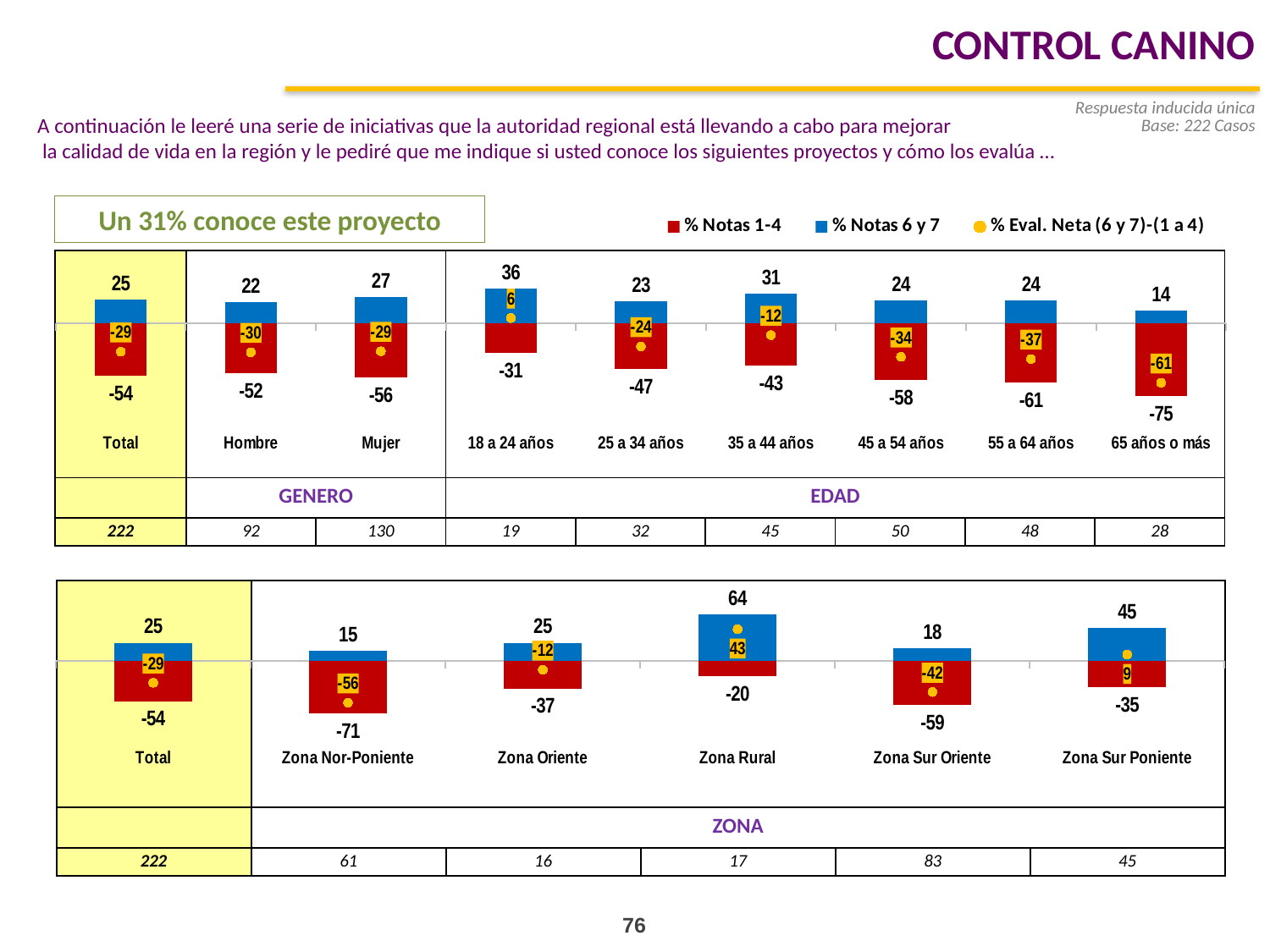
In the top chart, what is the % Notas 6 y 7 value for 18 a 24 años? 36 In the bottom chart, what is the % Eval. Neta value for Zona Sur Poniente? 9 In the top chart, what is the difference between the % Notas 6 y 7 values for Mujer and Hombre? 5 In the bottom chart, which zone has the lowest % Notas 1-4 value? Zona Nor-Poniente In the bottom chart, which is larger, the % Notas 6 y 7 value for Zona Sur Poniente or for Zona Sur Oriente? Zona Sur Poniente In the top chart, which age group has the highest % Notas 6 y 7 value? 18 a 24 años In the bottom chart, what is the % Notas 6 y 7 value for Zona Rural? 64 In the top chart, what is the % Eval. Neta value for Hombre? -30 How many series does the legend list? 3 What kind of chart is the bottom chart? Combination bar and line chart (stacked bars with dot markers for the net evaluation) In the top chart, what is the % Notas 1-4 value for 65 años o más? -75 In the top chart, which category has the lowest % Eval. Neta value? 65 años o más